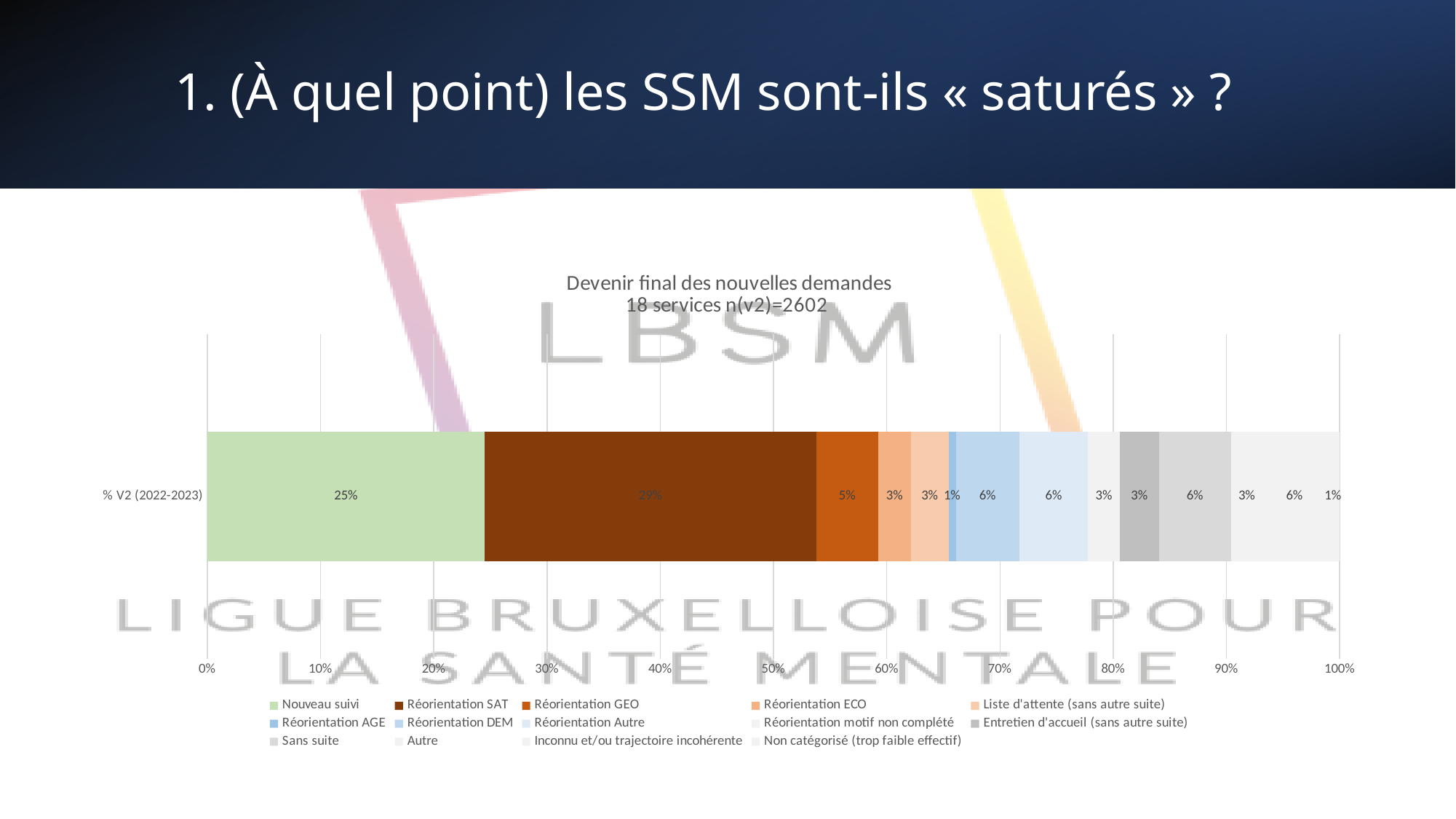
What is the value for Réorientation ECO? 3% How many series does the legend list? 14 What is the value for Nouveau suivi? 25% What is the value for Réorientation SAT? 29% What is the total of the stacked bar for % V2 (2022-2023)? 100% What type of chart is shown on the slide? Stacked bar chart What is the title of the chart? Devenir final des nouvelles demandes 18 services n(v2)=2602 What is the difference between Réorientation SAT and Nouveau suivi? 4% What is the value for Réorientation GEO? 5% How many categories (bars) are plotted on the chart? 1 Which series has the largest share of the bar? Réorientation SAT Which is larger, Nouveau suivi or Réorientation GEO? Nouveau suivi